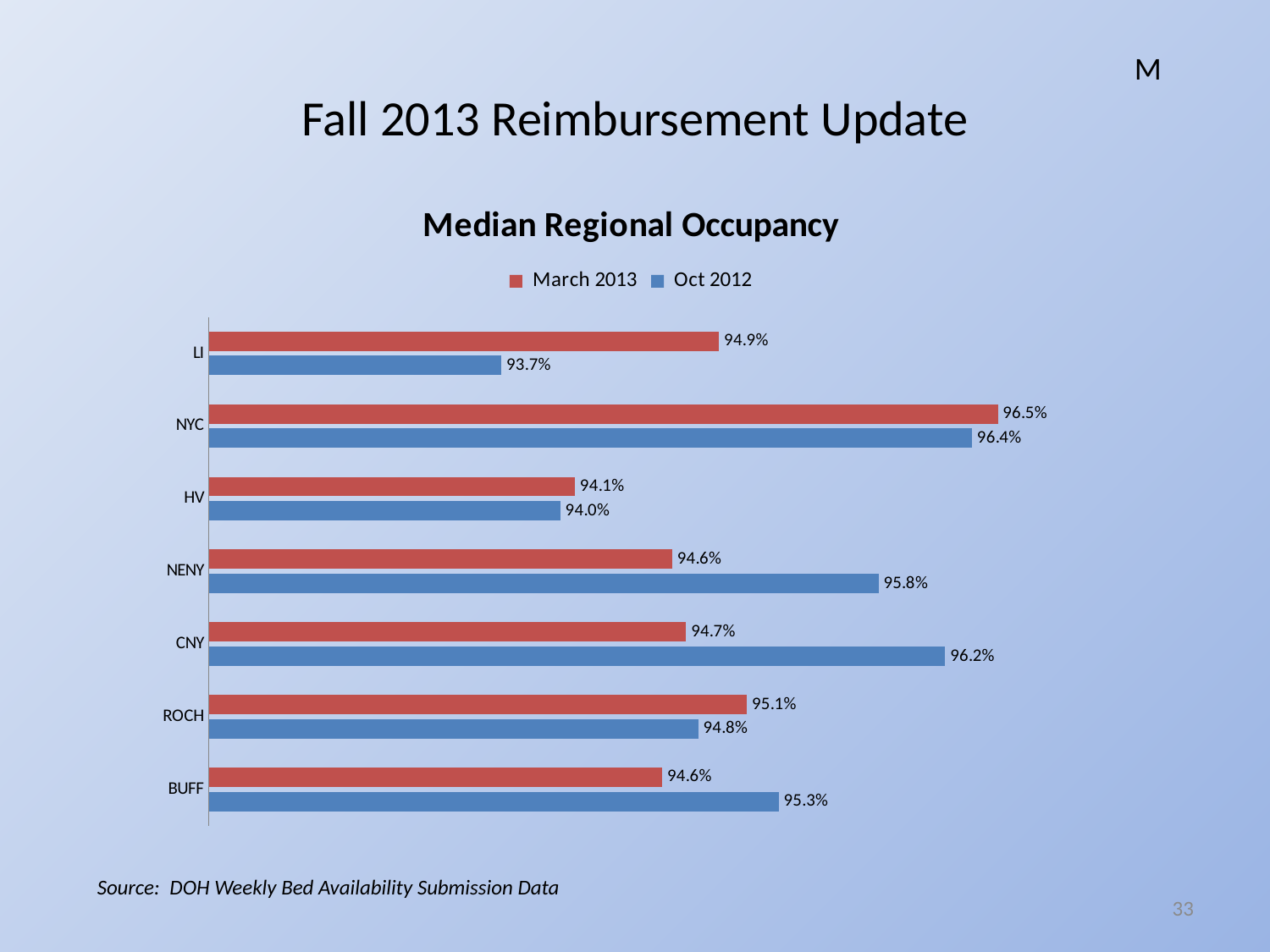
How many series does the legend list? 2 What kind of chart is shown on the slide? Bar chart What is the Oct 2012 median occupancy for LI? 93.7% How many regions are shown on the chart? 7 For BUFF, which is larger: the March 2013 value or the Oct 2012 value? Oct 2012 What is the difference between the Oct 2012 and March 2013 median occupancy for NENY? 1.2% What is the March 2013 median occupancy for ROCH? 95.1% Which region has the highest March 2013 median occupancy? NYC What is the Oct 2012 median occupancy for CNY? 96.2% Which region has the lowest Oct 2012 median occupancy? LI What is the March 2013 median occupancy for NYC? 96.5% What is the title of the chart? Median Regional Occupancy